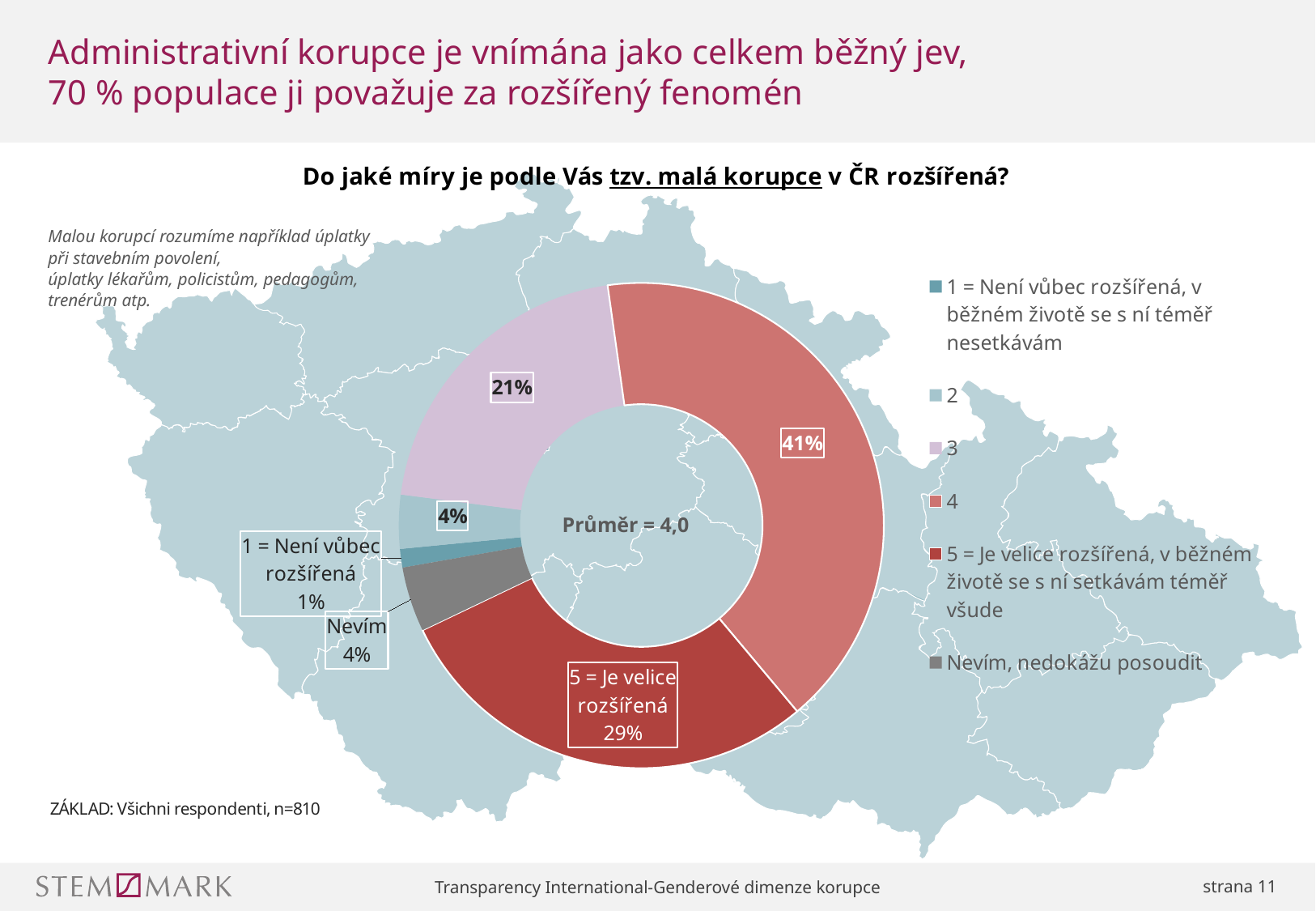
What percentage of respondents chose answer 3? 21% What average value (Průměr) is shown in the centre of the chart? 4,0 What percentage of respondents answered "Nevím"? 4% What is the difference in percentage points between answer 4 and answer 5? 12 Which is larger, the share for answer 3 or the share for answer 5? answer 5 How many entries does the legend list? 6 What type of chart is shown on the slide? pie chart (donut) Which answer category has the smallest share of the pie? 1 = Není vůbec rozšířená What percentage of respondents chose answer 4? 41% Which answer category has the largest share of the pie? 4 What percentage of respondents chose "5 = Je velice rozšířená"? 29% What percentage of respondents chose "1 = Není vůbec rozšířená"? 1%